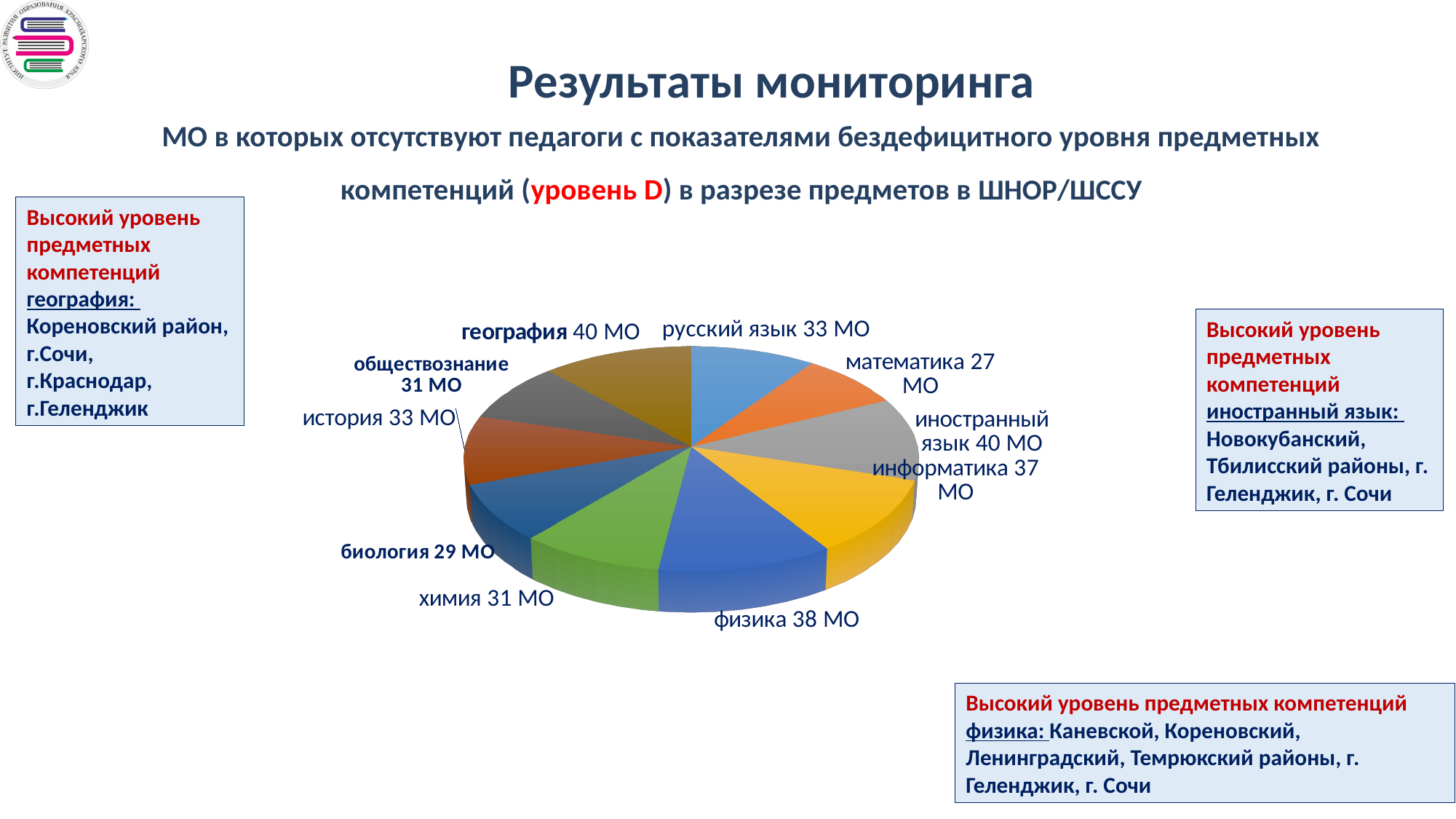
What is the value for биология in the pie chart? 29 МО What is the value for география in the pie chart? 40 МО What kind of chart is shown on the slide? pie chart What is the difference between the values for физика and химия? 7 МО What is the main title of the slide? Результаты мониторинга What is the value for информатика in the pie chart? 37 МО What is the difference between the values for иностранный язык and математика? 13 МО What is the value for математика in the pie chart? 27 МО What is the value for физика in the pie chart? 38 МО Which has the larger value, информатика or русский язык? информатика Which subject has the lowest value in the pie chart? математика How many categories (subjects) does the pie chart show? 10